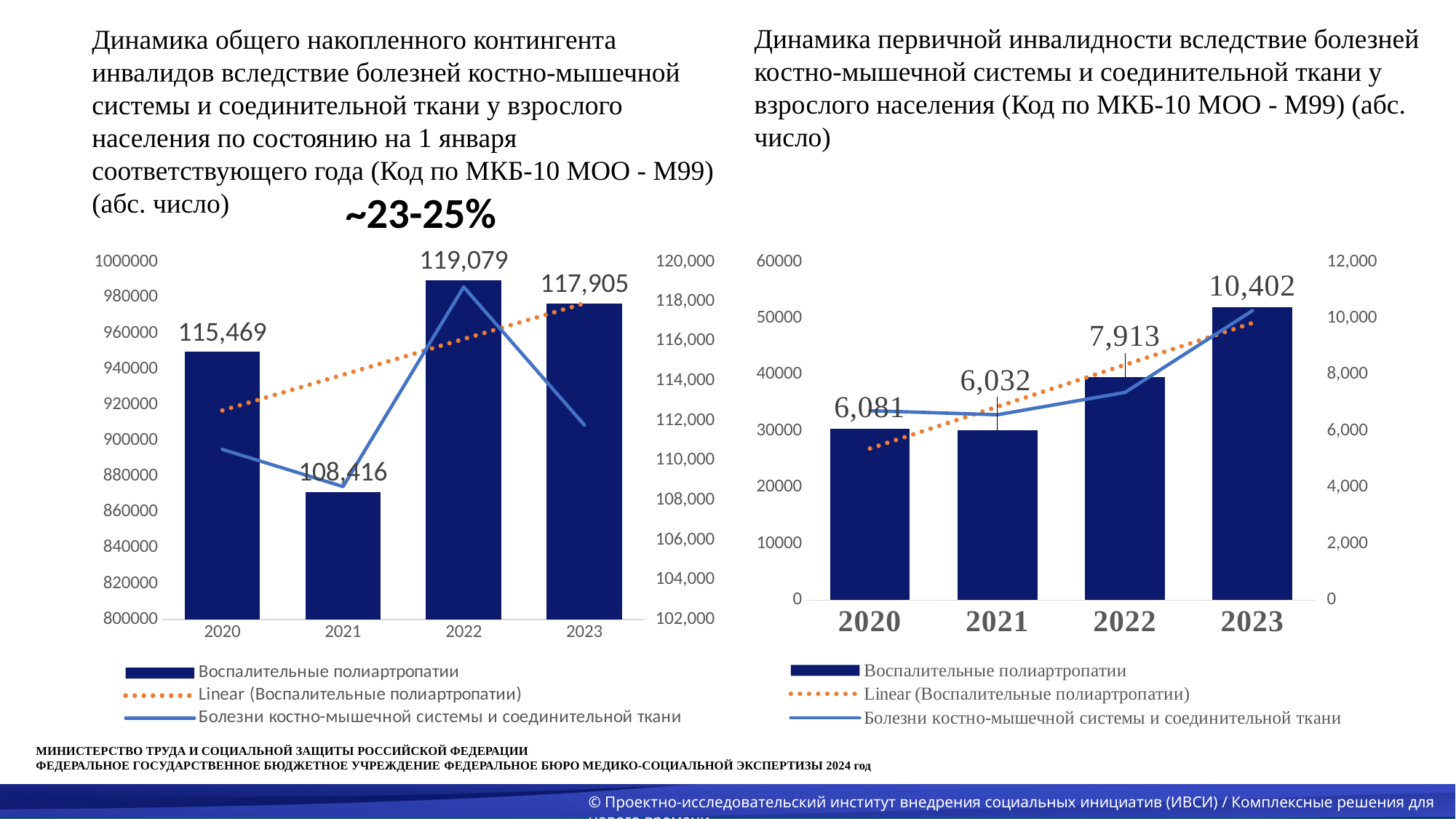
How many years are shown on the x axis of the right chart? 4 In the right chart, what is the difference between the labelled values for 2023 and 2022? 2,489 In the right chart, which year has the highest labelled value for Воспалительные полиартропатии? 2023 In the left chart, what is the data label for Воспалительные полиартропатии in 2021? 108,416 In the left chart, how many series does the legend list? 3 In the left chart, what is the difference between the labelled values for 2022 and 2023? 1,174 In the right chart, is the labelled value for 2022 larger or smaller than the labelled value for 2021? larger In the right chart, what is the data label for Воспалительные полиартропатии in 2023? 10,402 In the left chart, which year has the highest labelled value for Воспалительные полиартропатии? 2022 In the left chart, what is the data label for Воспалительные полиартропатии in 2022? 119,079 In the right chart, what is the data label for Воспалительные полиартропатии in 2020? 6,081 In the left chart, which year has the lowest labelled value for Воспалительные полиартропатии? 2021